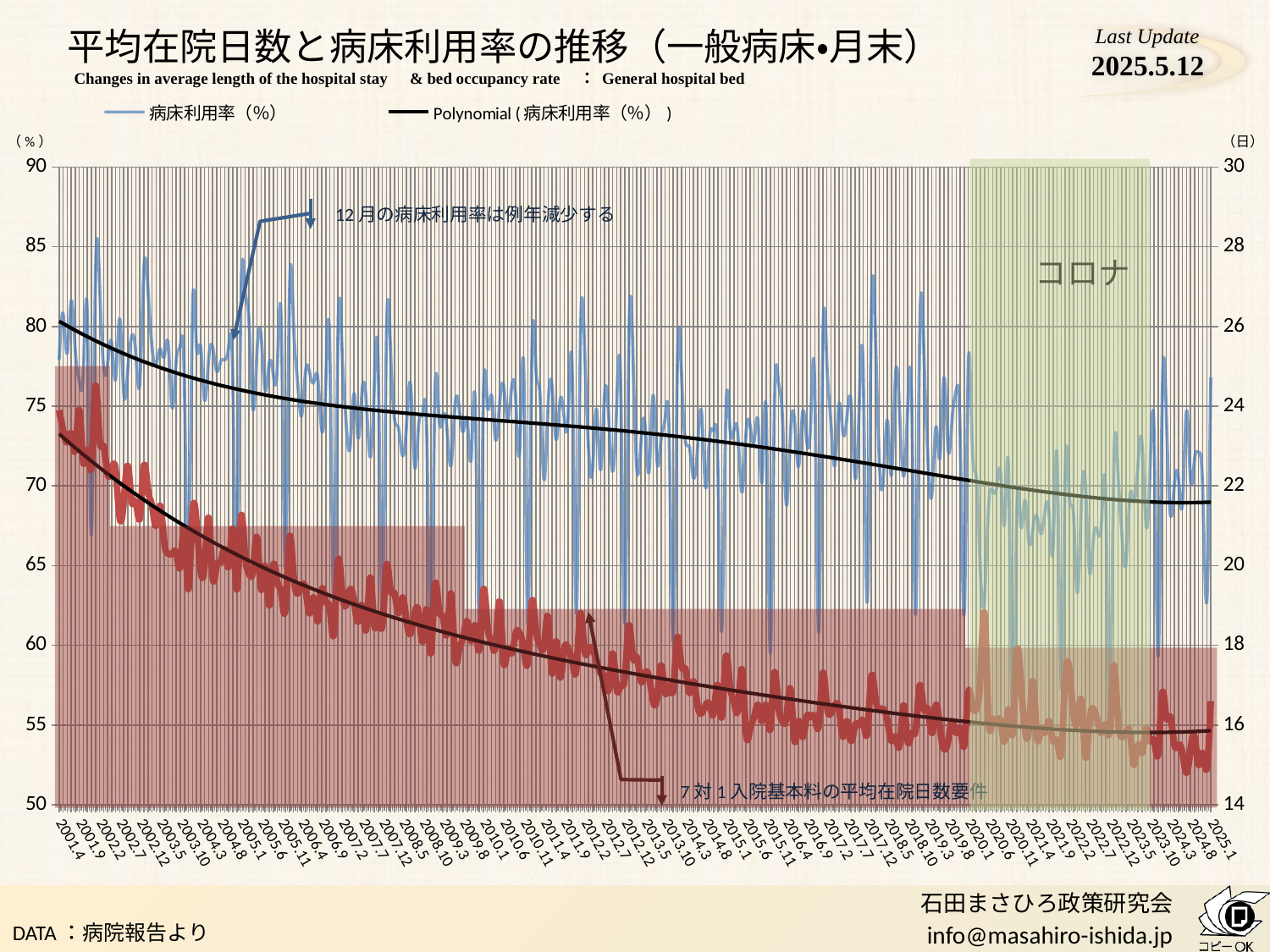
How many series does the legend list? 2 Does the 病床利用率（%） series generally rise or fall from 2001.4 to 2025.1? fall Is the value of the Polynomial (病床利用率（%）) line at 2025.1 greater or less than 75? less What is the highest value shown on the left (%) axis? 90 On the right axis (日), is the average length of stay (red line) at 2001.4 greater or less than 22? greater What is the title of the chart? 平均在院日数と病床利用率の推移（一般病床•月末） What kind of chart is shown on the slide? line chart Does the Polynomial (病床利用率（%）) trend line rise or fall along the x axis? fall Is the value of the Polynomial (病床利用率（%）) line at 2001.4 greater or less than 75? greater